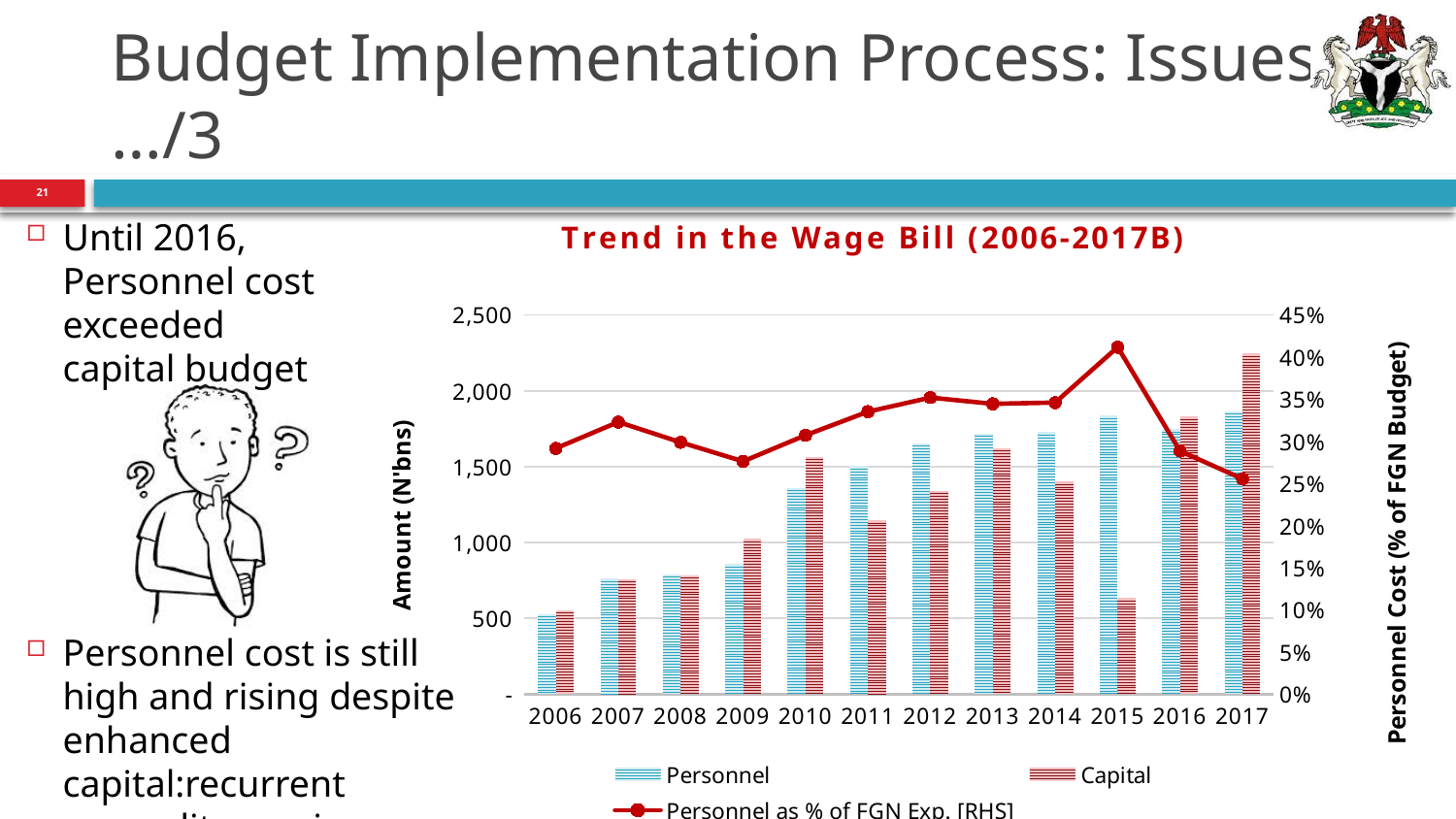
Is the Personnel value for 2006 greater or less than 1,000? less Is the Capital value for 2015 greater or less than 1,000? less Is the Capital value for 2017 greater or less than 2,000? greater Does the Capital bar rise or fall from 2015 to 2017? rise How many series does the chart's legend list? 3 What kind of chart is used to show Personnel and Capital amounts? Bar chart (with a line for Personnel as % of FGN Exp.) In which year does the Personnel as % of FGN Exp. line reach its highest point? 2015 In which year is the Capital bar highest? 2017 In 2015, which is larger, the Personnel bar or the Capital bar? Personnel In 2017, which is larger, the Personnel bar or the Capital bar? Capital What is the title of the chart on the slide? Trend in the Wage Bill (2006-2017B) How many years are shown on the x axis of the chart? 12